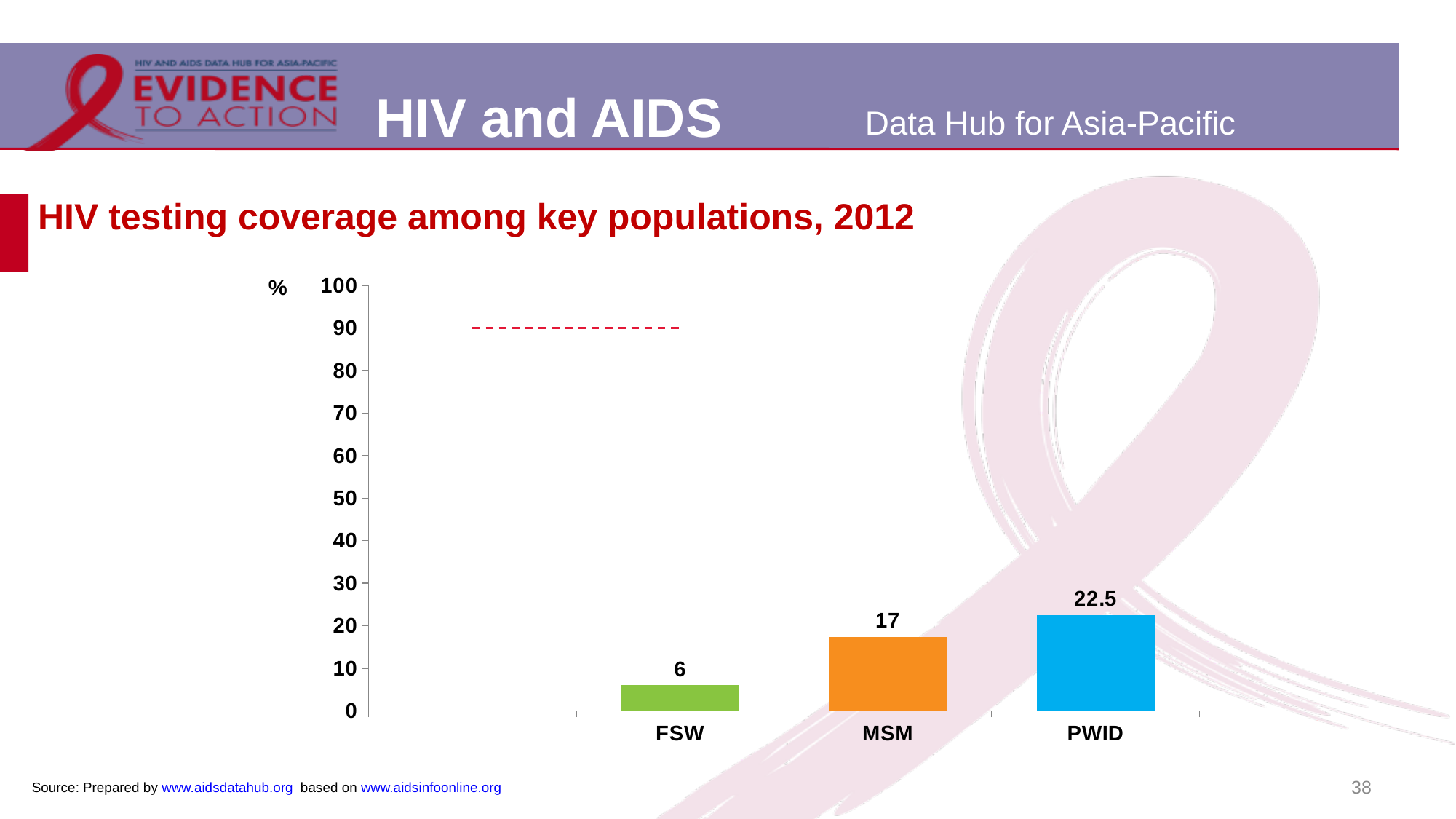
What is the HIV testing coverage value for PWID? 22.5 Which has a higher HIV testing coverage, FSW or MSM? MSM How many key populations are shown in the chart? 3 Is the value for PWID greater or less than 20? greater What is the HIV testing coverage value for FSW? 6 What is the difference between the HIV testing coverage for MSM and FSW? 11 What is the HIV testing coverage value for MSM? 17 What is the difference between the HIV testing coverage for PWID and MSM? 5.5 Which key population has the highest HIV testing coverage? PWID What kind of chart is shown on the slide? bar chart What is the title of the chart on the slide? HIV testing coverage among key populations, 2012 Which key population has the lowest HIV testing coverage? FSW